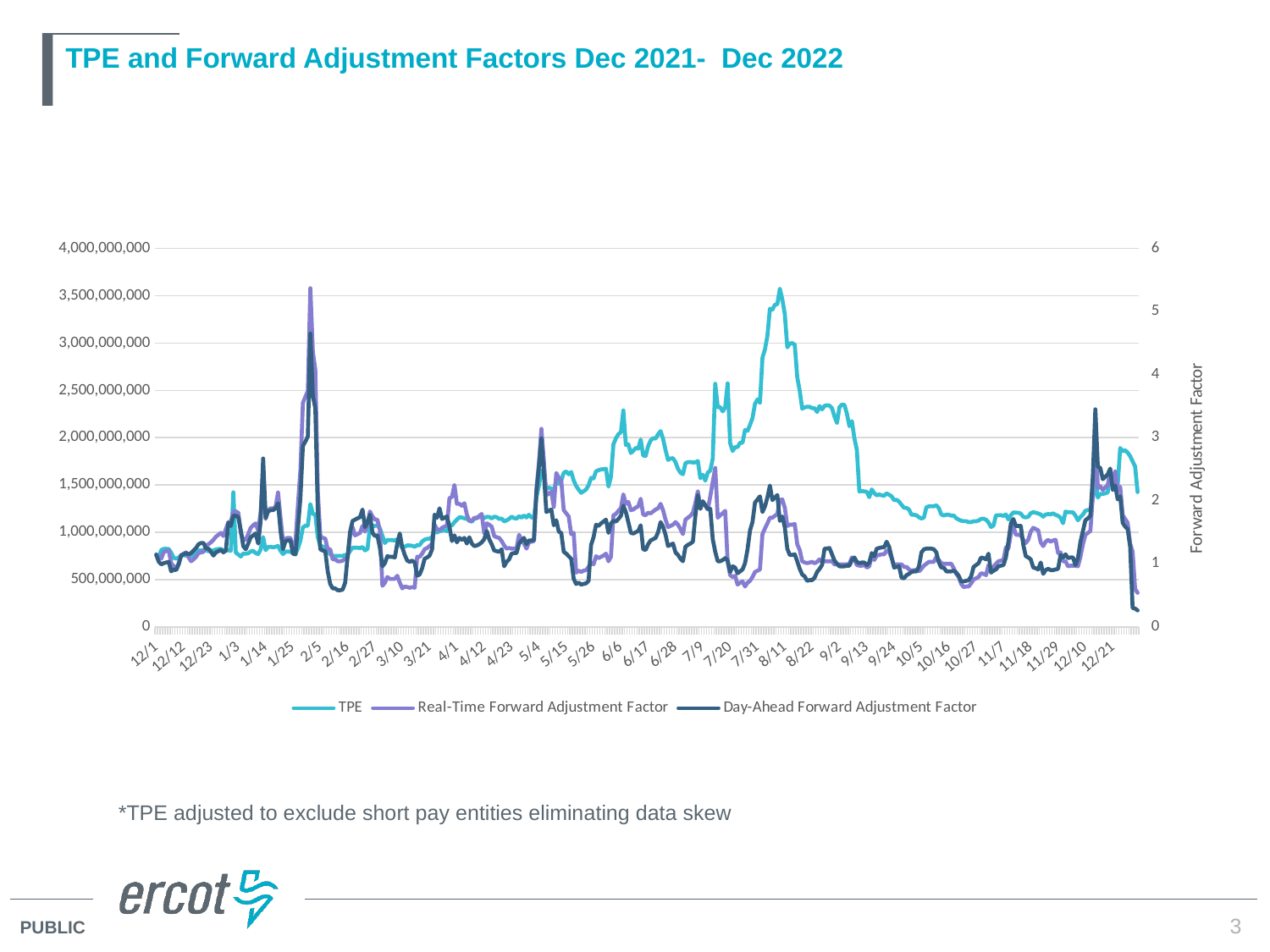
What is the title of the chart? TPE and Forward Adjustment Factors Dec 2021- Dec 2022 Is the TPE value at 12/1 greater or less than 1,000,000,000? less Is the Day-Ahead Forward Adjustment Factor at the far right end of the chart (after 12/21) greater or less than 1? less Is the peak value of the TPE line around 8/11 greater or less than 3,000,000,000? greater How many series does the legend list? 3 What is the label of the right-hand vertical axis? Forward Adjustment Factor Does the TPE line rise or fall between 8/11 and 9/13? fall Which series reaches the highest value on the right-hand Forward Adjustment Factor axis? Real-Time Forward Adjustment Factor Is the TPE value larger around 8/11 or around 12/1? 8/11 What kind of chart is shown on the slide? Line chart